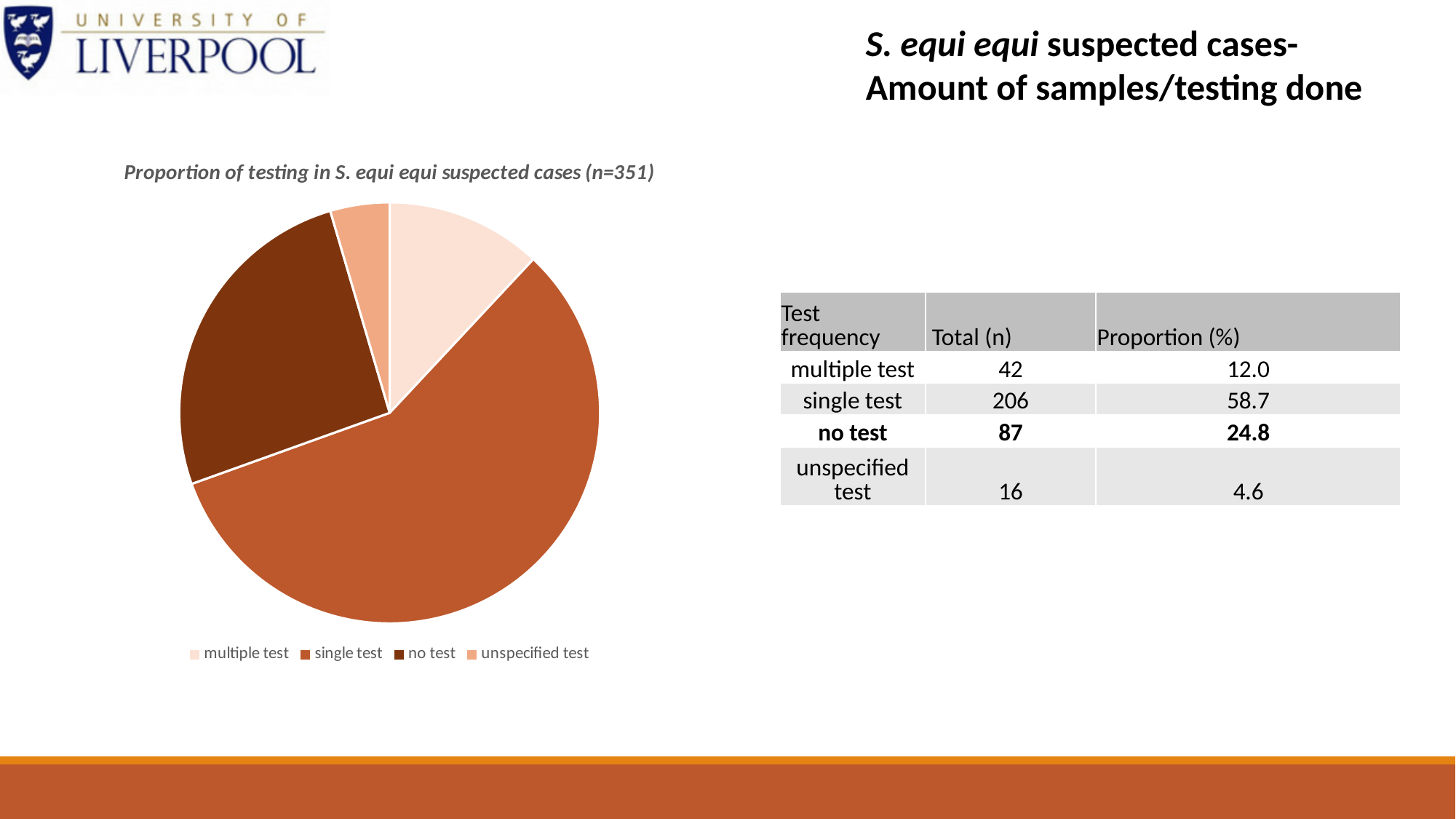
According to the table, how many suspected cases (n) had no test? 87 According to the table, what proportion (%) of suspected cases had a single test? 58.7 Which category takes the largest slice of the pie chart? single test What kind of chart is shown on the slide? pie chart Which category takes the smallest slice of the pie chart? unspecified test What is the title of the pie chart? Proportion of testing in S. equi equi suspected cases (n=351) According to the table, what proportion (%) of suspected cases had multiple tests? 12.0 According to the table, how many suspected cases (n) had an unspecified test? 16 Which slice is larger in the pie chart, no test or multiple test? no test How many entries does the pie chart's legend list? 4 Which slice is larger in the pie chart, multiple test or unspecified test? multiple test How many slices does the pie chart have? 4